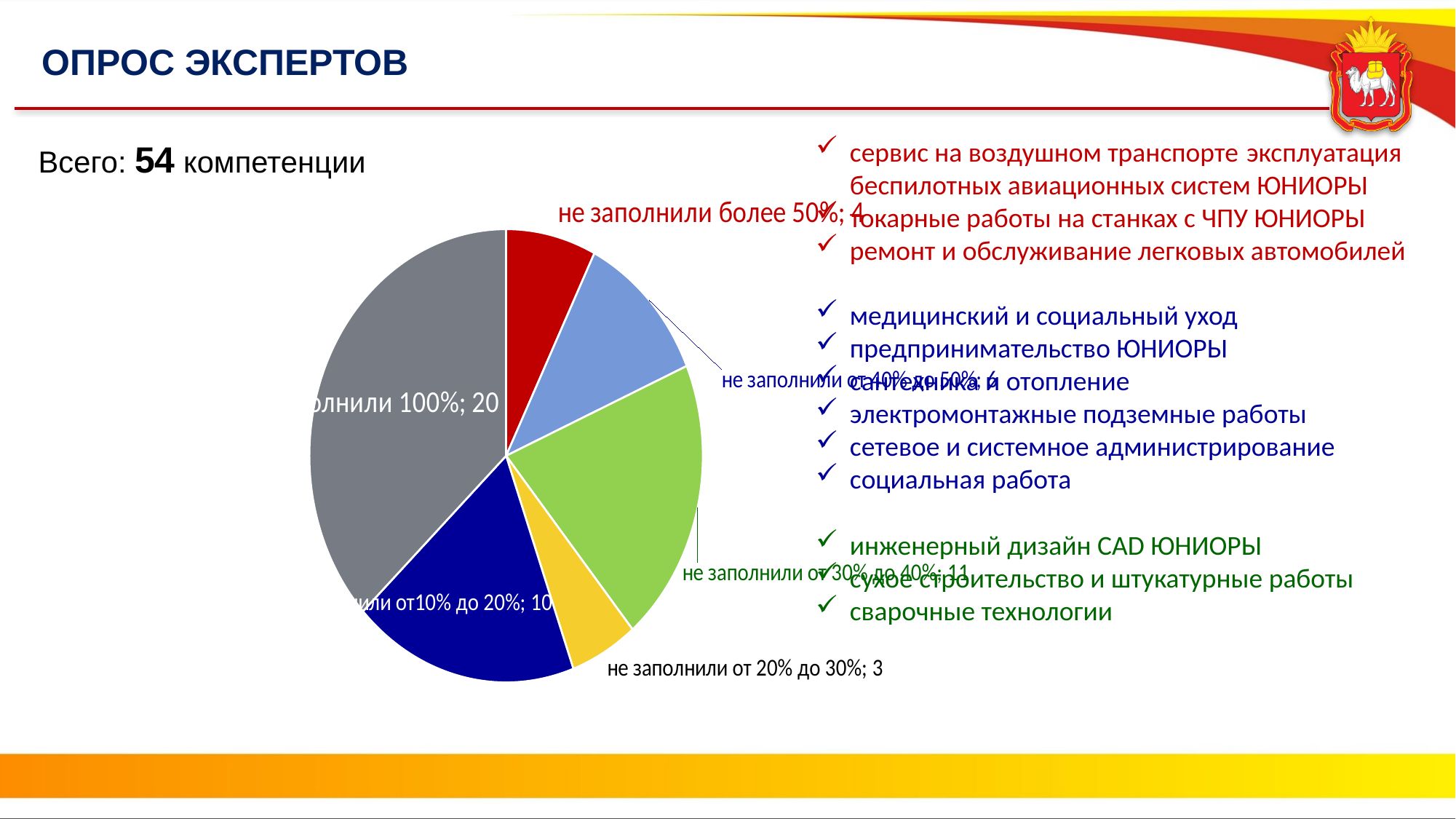
What is the value shown for the gray slice of the pie chart? 20 What is the value for "не заполнили более 50%" in the pie chart? 4 What type of chart is shown on the slide? pie chart What is the value for "не заполнили от 20% до 30%" in the pie chart? 3 What colour is the slice for "не заполнили более 50%" in the pie chart? red Which is larger: the value for "не заполнили более 50%" or for "не заполнили от 20% до 30%"? не заполнили более 50% How many slices does the pie chart have? 6 What is the difference between the values for "не заполнили от 30% до 40%" and "не заполнили от 40% до 50%"? 5 Which slice of the pie chart has the smallest value? не заполнили от 20% до 30% What is the value shown for the dark blue slice of the pie chart? 10 What is the value for "не заполнили от 40% до 50%" in the pie chart? 6 What is the value for "не заполнили от 30% до 40%" in the pie chart? 11